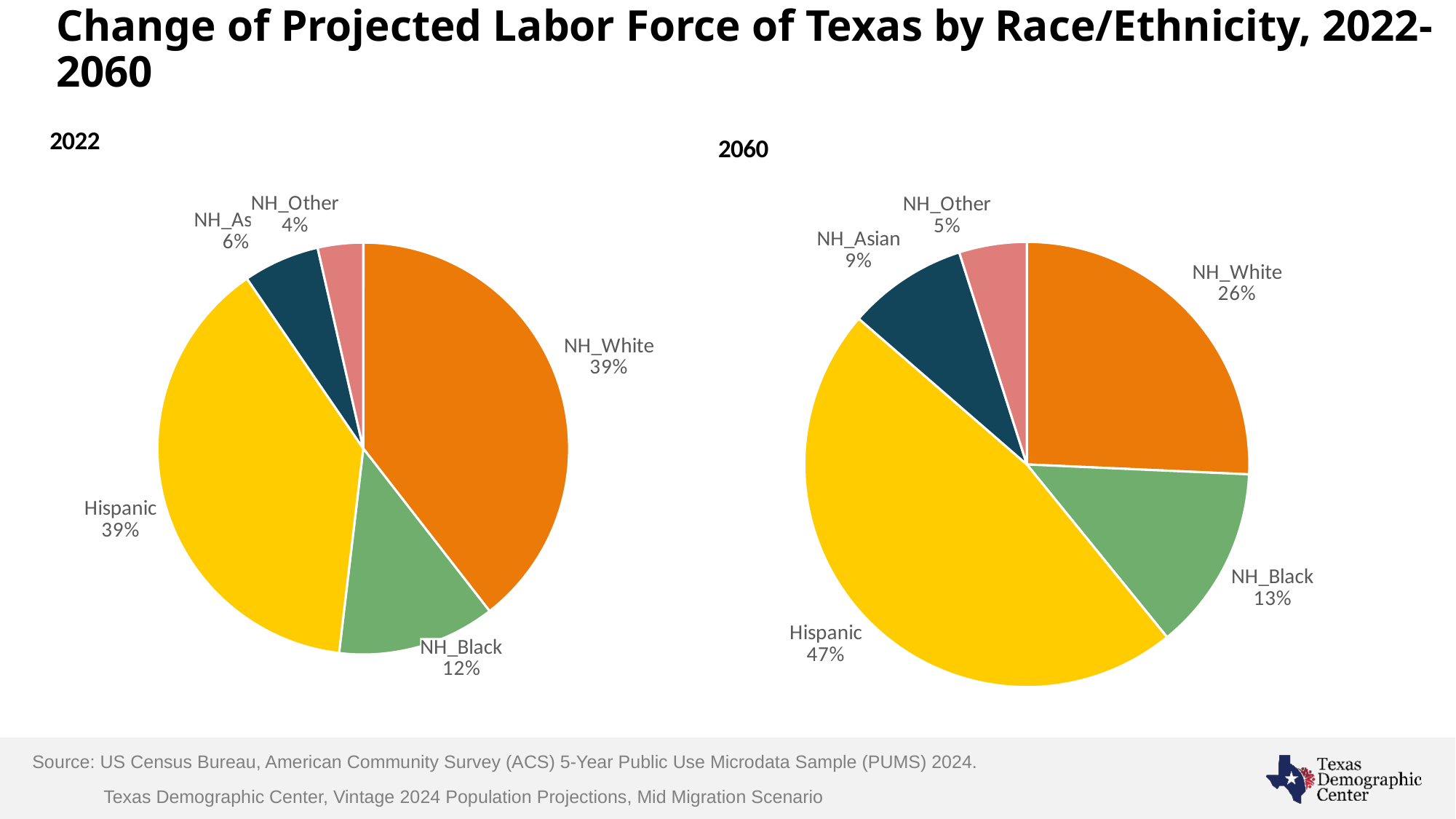
In the 2022 pie chart, which category has the smallest share? NH_Other In the 2060 pie chart, which category has the largest share? Hispanic What is the difference between the Hispanic share in the 2060 pie chart and the Hispanic share in the 2022 pie chart? 8 percentage points In the 2022 pie chart, what share of the labor force is NH_Black? 12% In the 2060 pie chart, which category has the smallest share? NH_Other What colour is the Hispanic slice in both pie charts? Yellow In the 2060 pie chart, which is larger, the NH_Black share or the NH_Asian share? NH_Black How many slices does the 2060 pie chart have? 5 In the 2022 pie chart, what share of the labor force is NH_Other? 4% In the 2060 pie chart, what share of the labor force is NH_White? 26% What type of chart is used to show the 2022 labor force breakdown? Pie chart In the 2060 pie chart, what share of the labor force is Hispanic? 47%